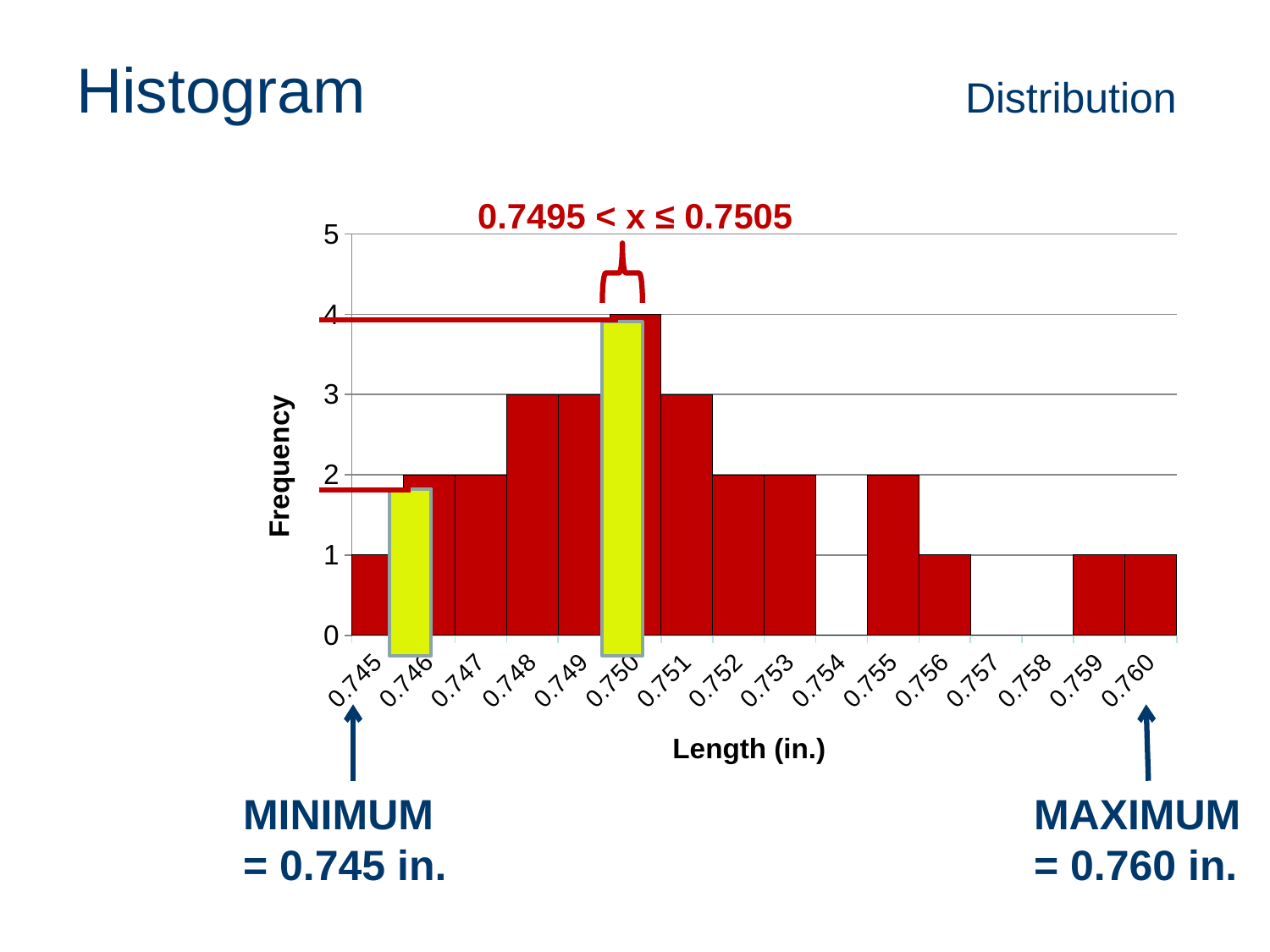
Which length has the highest frequency? 0.750 How many length categories are labelled on the x axis? 16 What is the frequency for a length of 0.745 in.? 1 What is the frequency for a length of 0.755 in.? 2 What is the difference in frequency between 0.750 in. and 0.746 in.? 2 Which has a higher frequency, 0.751 in. or 0.752 in.? 0.751 What is the frequency for a length of 0.750 in.? 4 What kind of chart is shown on the slide? bar chart (histogram) Is the frequency for 0.749 in. greater or less than 2? greater What is the frequency for a length of 0.748 in.? 3 What is the title of the x axis? Length (in.) What is the title of the y axis? Frequency